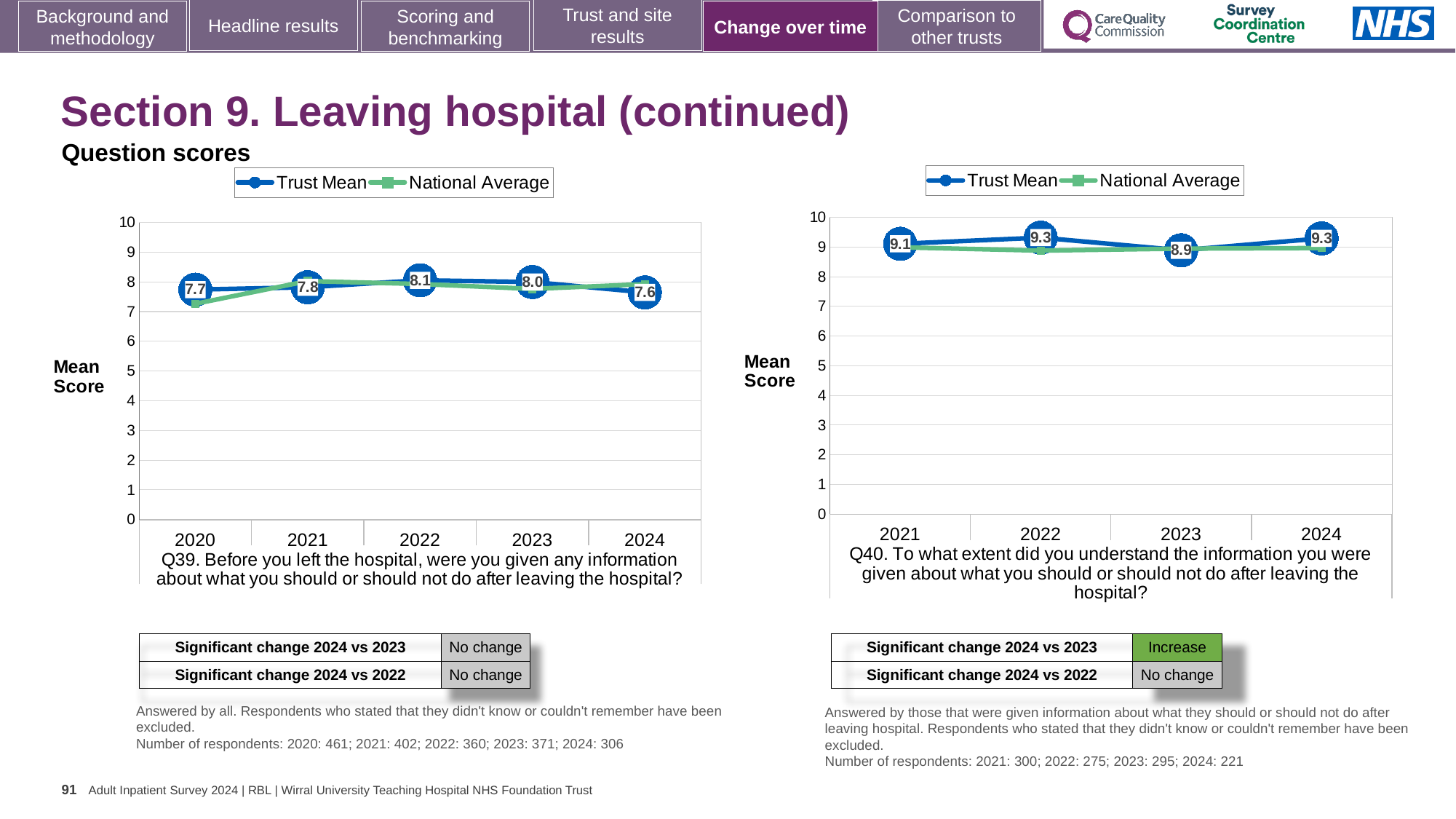
In the Q40 chart on the right, what is the difference between the Trust Mean scores for 2024 and 2023? 0.4 In the Q39 chart on the left, what is the Trust Mean score for 2022? 8.1 How many series does the legend of the Q39 chart on the left list? 2 In the Q39 chart on the left, is the National Average value for 2020 greater or less than 8? less In the Q40 chart on the right, which year has the lowest Trust Mean score? 2023 In the Q40 chart on the right, what is the Trust Mean score for 2023? 8.9 In the Q39 chart on the left, what is the Trust Mean score for 2024? 7.6 In the Q39 chart on the left, which year has the lowest Trust Mean score? 2024 How many years are plotted on the x axis of the Q40 chart on the right? 4 In the Q39 chart on the left, what is the difference between the Trust Mean scores for 2022 and 2024? 0.5 In the Q39 chart on the left, is the Trust Mean score higher in 2021 or in 2023? 2023 In the Q39 chart on the left, which year has the highest Trust Mean score? 2022